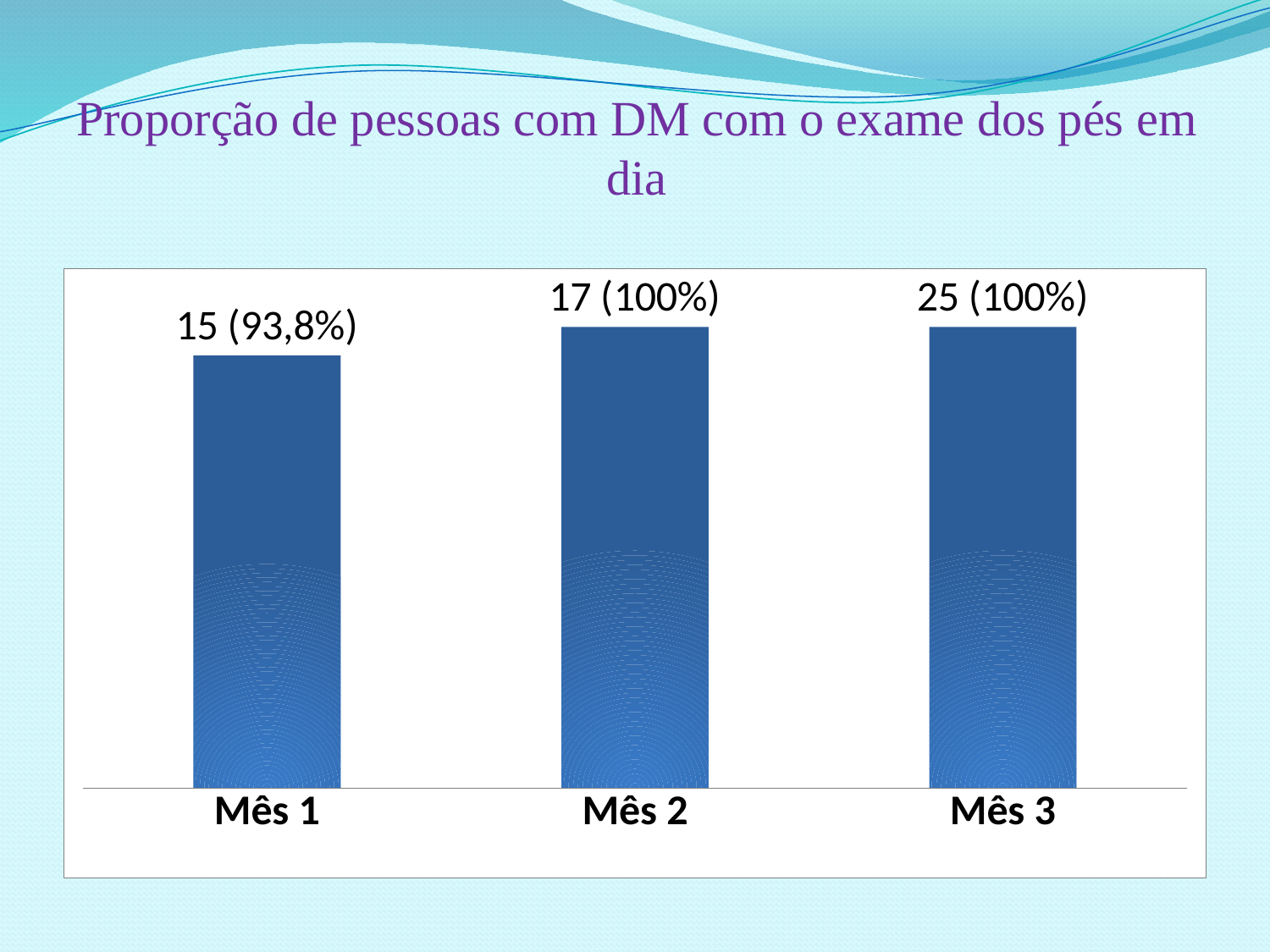
Which month has the highest number of people shown in its data label? Mês 3 Which month has the lowest bar? Mês 1 What is the title of the slide? Proporção de pessoas com DM com o exame dos pés em dia What type of chart is shown on the slide? Bar chart What percentage is shown for Mês 1? 93,8% What is the data label shown for Mês 2? 17 (100%) What is the data label shown for Mês 3? 25 (100%) How many months (categories) are shown on the x axis? 3 Do the percentages rise or fall from Mês 1 to Mês 2? Rise What is the data label shown for Mês 1? 15 (93,8%) How many more people are shown for Mês 3 than for Mês 2? 8 Which has a higher percentage, Mês 1 or Mês 3? Mês 3